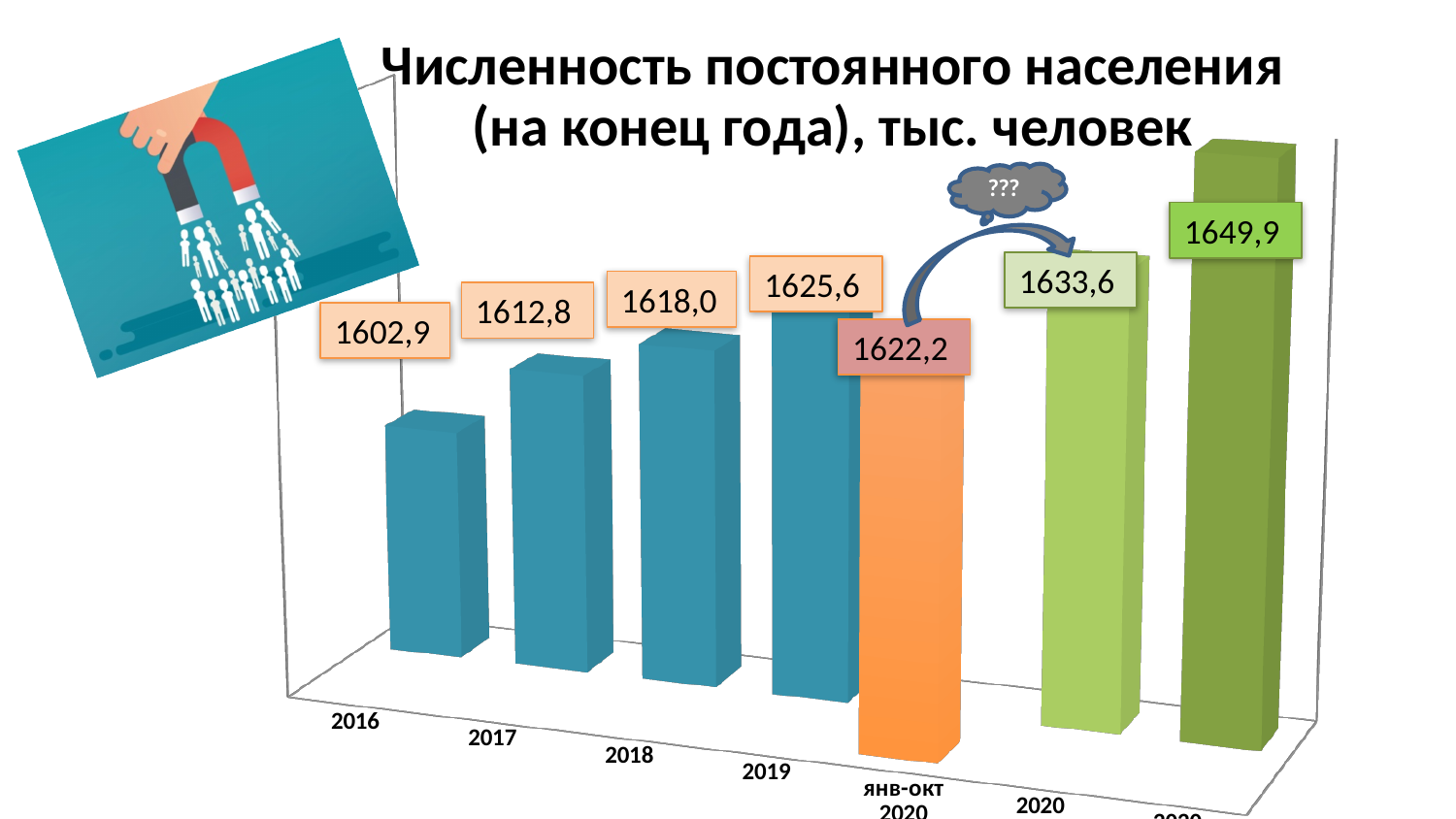
Which year has the lowest value? 2016 What is the value for янв-окт 2020? 1622,2 Which is larger, the value for 2019 or the value for янв-окт 2020? 2019 What is the difference between the values for 2019 and 2016? 22,7 How many bars are shown on the chart? 7 What is the value for 2018? 1618,0 What is the highest value shown on the chart? 1649,9 What is the title of the chart? Численность постоянного населения (на конец года), тыс. человек What is the value for 2019? 1625,6 What kind of chart is shown on the slide? Bar chart What is the value for 2016? 1602,9